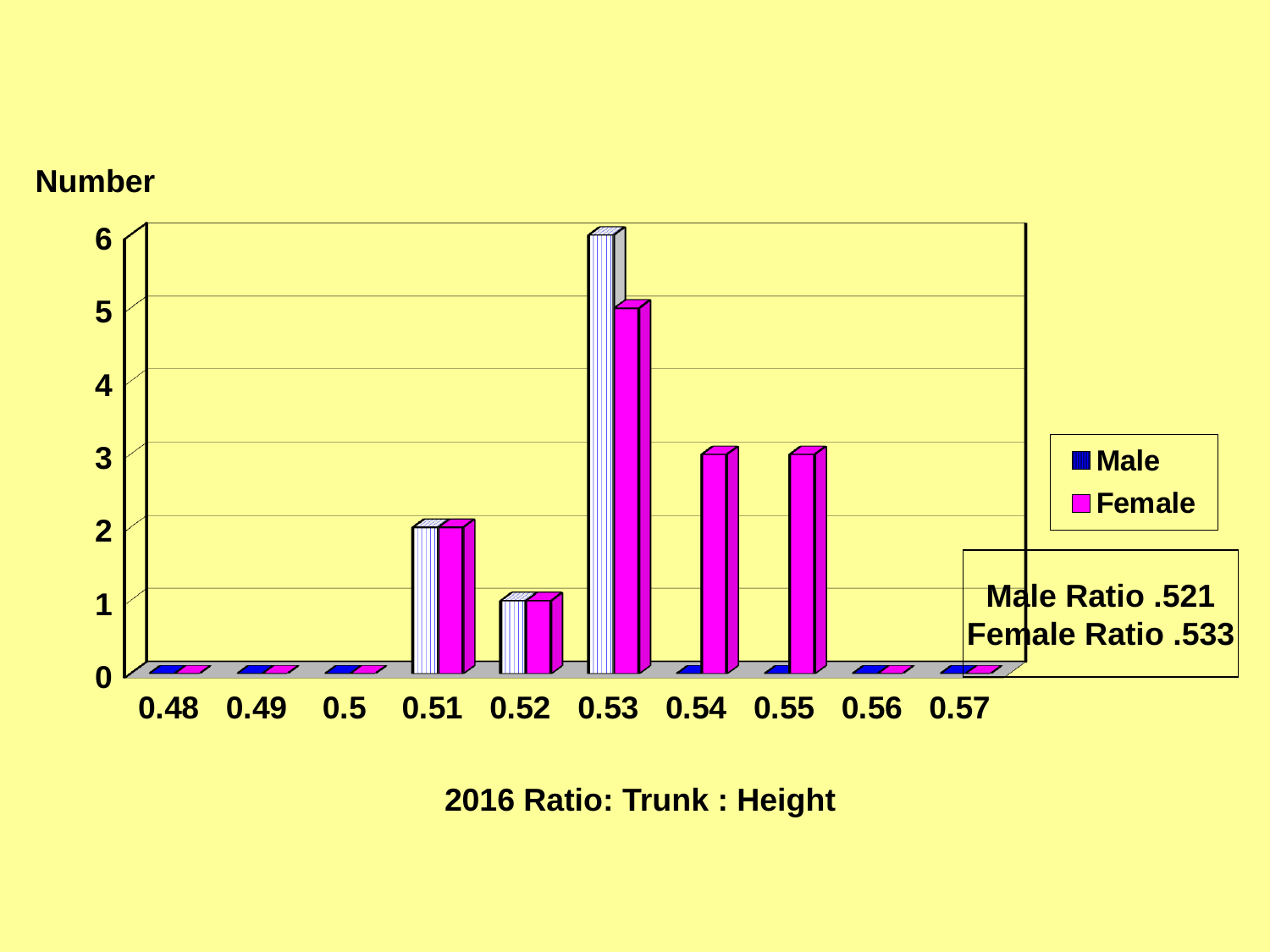
What is the difference between the Male and Female values at the 0.53 ratio? 1 What kind of chart is shown on the slide? bar chart At which ratio is the Female series highest? 0.53 How many series does the legend list? 2 What Female Ratio is stated in the text box on the chart? .533 What is the Female value at the 0.54 ratio? 3 How many ratio categories are shown along the x axis? 10 What is the Male value at the 0.51 ratio? 2 What is the Female value at the 0.53 ratio? 5 At which ratio is the Male series highest? 0.53 What is the Male value at the 0.53 ratio? 6 At the 0.55 ratio, which series has the larger value, Male or Female? Female